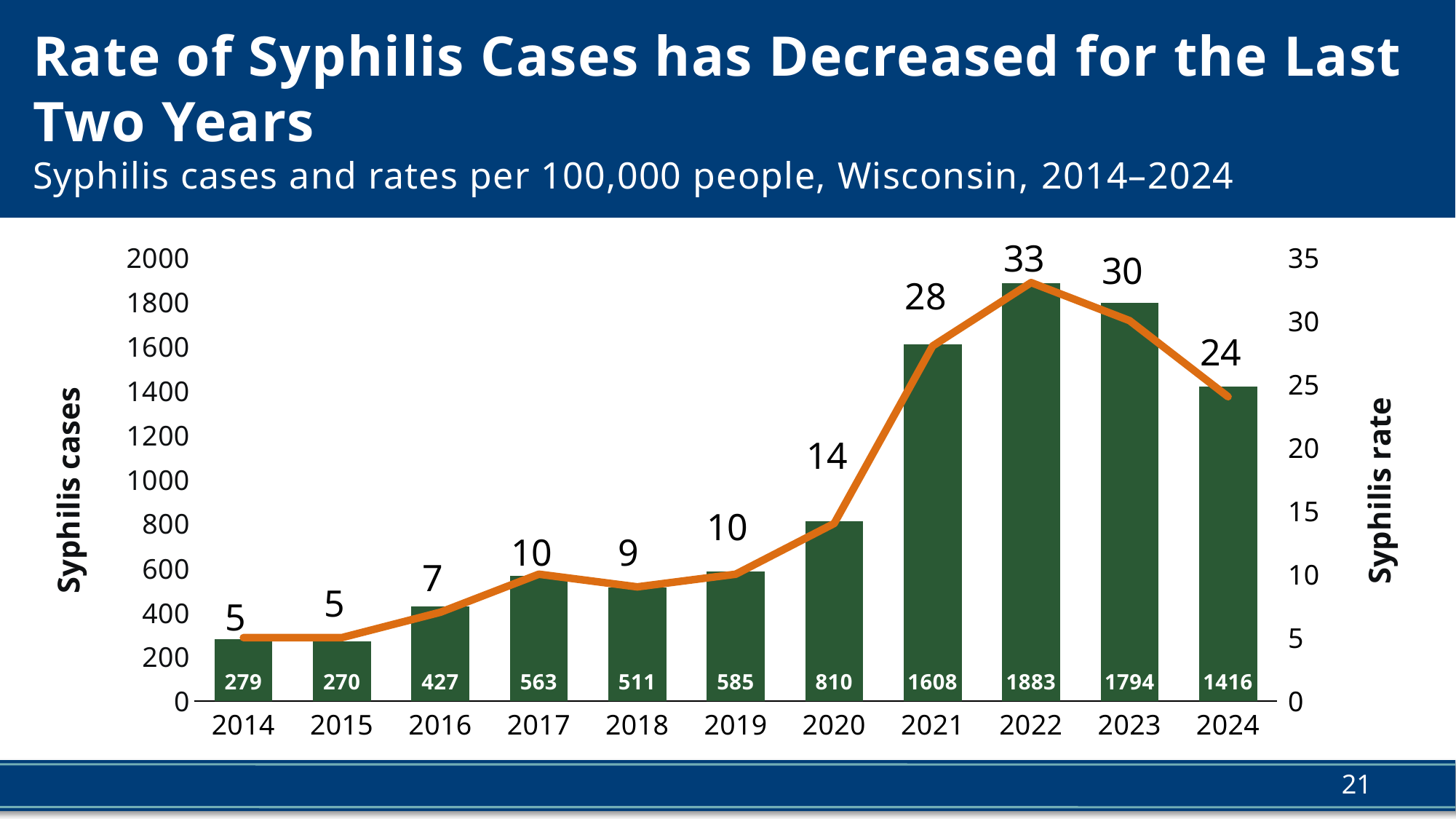
How many years are shown on the x axis of the chart? 11 Which year had more syphilis cases, 2017 or 2018? 2017 How did the syphilis rate change from 2022 to 2024? It fell What colour is the line showing the syphilis rate? Orange What is the difference in syphilis cases between 2022 and 2024? 467 What was the syphilis rate per 100,000 people in 2021? 28 Which year had the lowest number of syphilis cases? 2015 What is the label of the right-hand vertical axis? Syphilis rate Which year had the highest number of syphilis cases? 2022 What kind of chart is used to show syphilis cases? bar chart Is the number of syphilis cases in 2020 greater or less than 1000? less How many syphilis cases were reported in Wisconsin in 2022? 1883